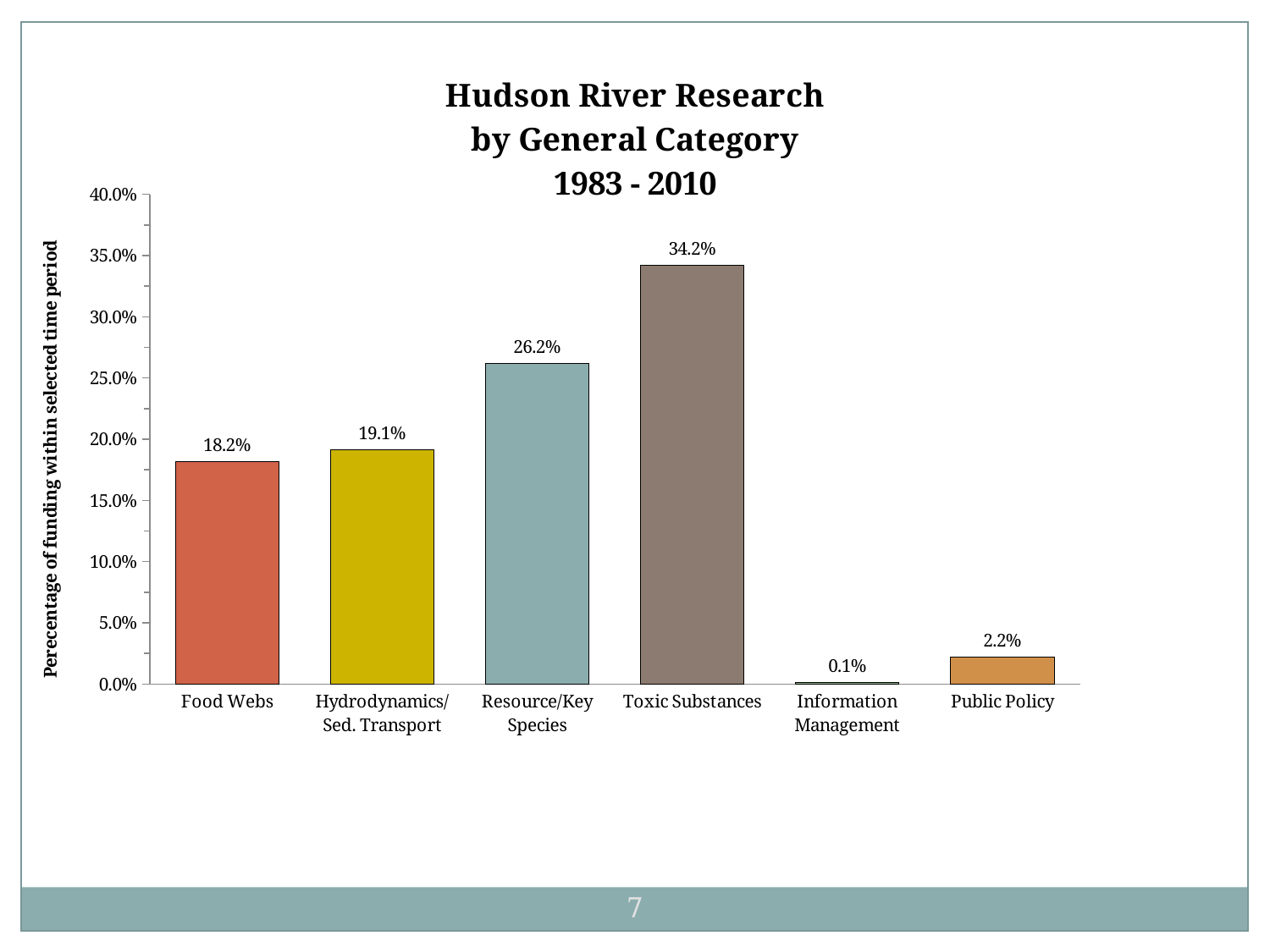
Which category received the lowest percentage of funding? Information Management What percentage of funding is shown for Information Management? 0.1% What is the difference between the values for Toxic Substances and Resource/Key Species? 8.0% What is the label of the vertical axis? Perecentage of funding within selected time period Which is larger, the value for Resource/Key Species or the value for Hydrodynamics/Sed. Transport? Resource/Key Species Is the value for Public Policy greater or less than 5.0%? less How many categories are shown on the chart? 6 What percentage of funding went to Toxic Substances? 34.2% Which category received the highest percentage of funding? Toxic Substances What is the value shown for Food Webs? 18.2% What is the difference between the values for Hydrodynamics/Sed. Transport and Food Webs? 0.9% What kind of chart is shown on the slide? bar chart